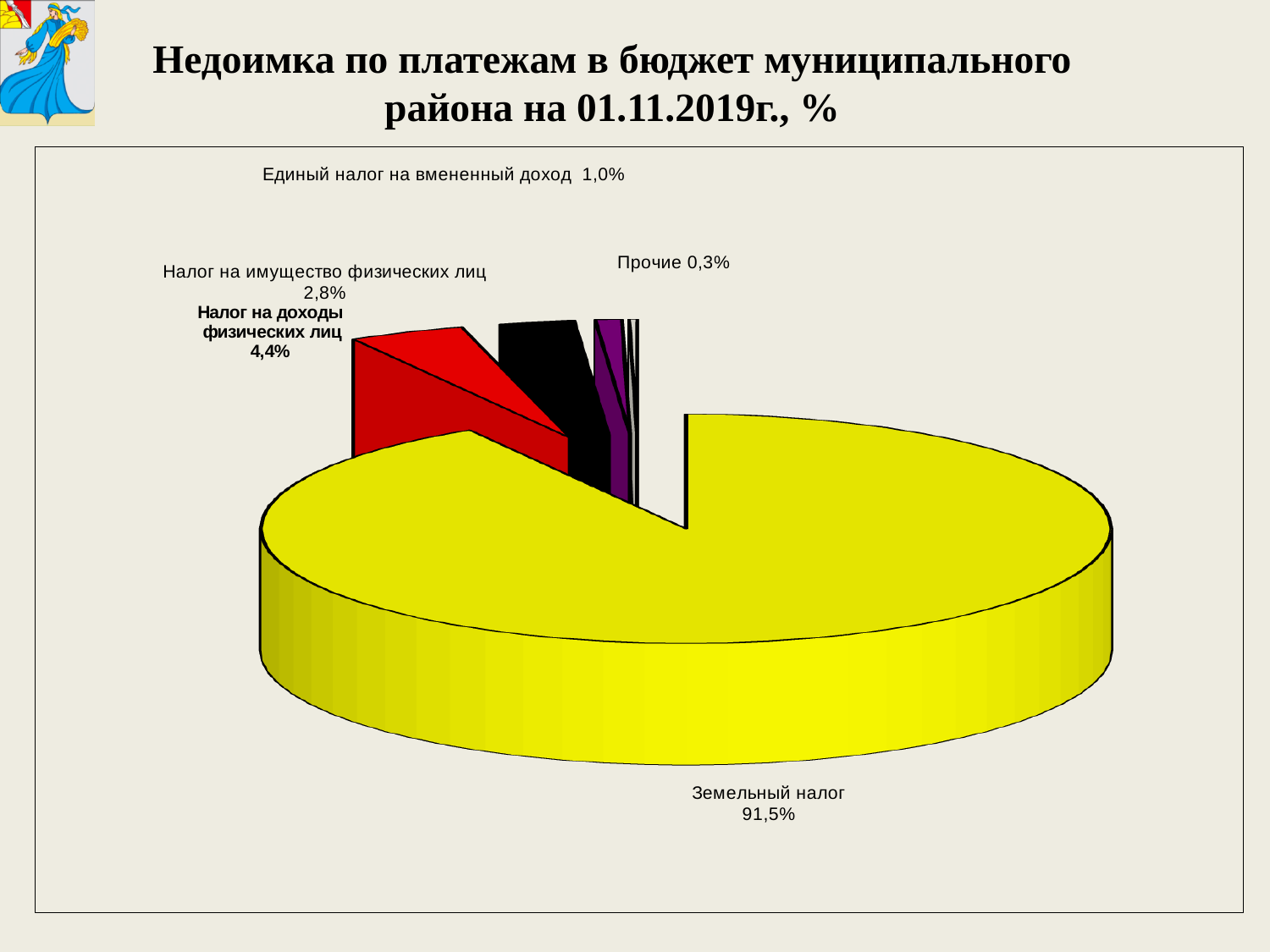
What is the value shown for Налог на доходы физических лиц? 4,4% Which category has the smallest share of the pie? Прочие What share of the pie does Земельный налог have? 91,5% What is the value shown for Налог на имущество физических лиц? 2,8% What kind of chart is shown on the slide? Pie chart How many slices does the pie chart have? 5 Which category has the largest share of the pie? Земельный налог What is the value shown for Единый налог на вмененный доход? 1,0% Which is larger: Налог на доходы физических лиц or Налог на имущество физических лиц? Налог на доходы физических лиц What is the difference between the shares of Налог на доходы физических лиц and Налог на имущество физических лиц? 1,6% What is the title of the chart on the slide? Недоимка по платежам в бюджет муниципального района на 01.11.2019г., % What is the value shown for Прочие? 0,3%